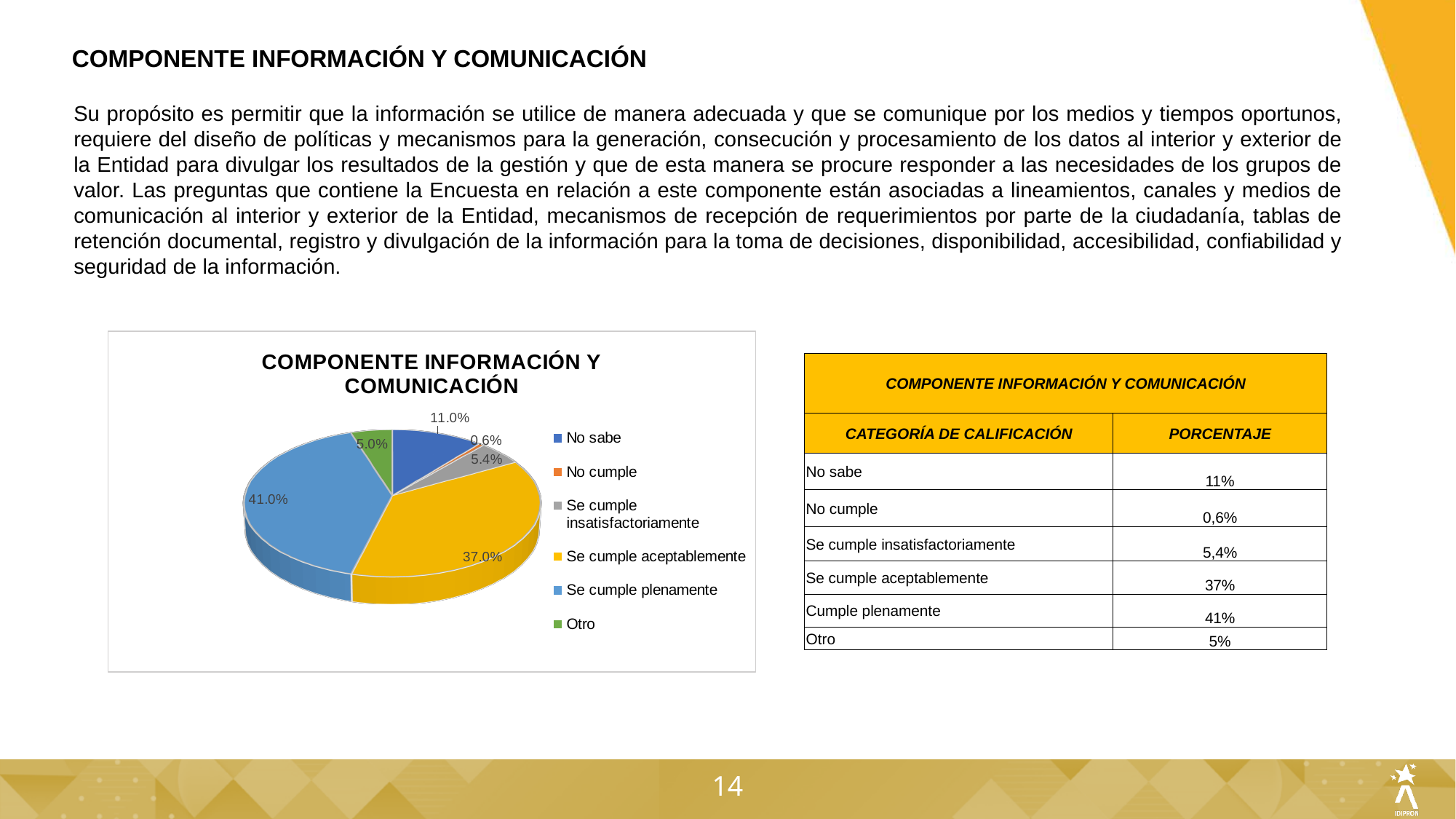
What is the value for "No sabe" in the pie chart? 11.0% What is the value for "No cumple" in the pie chart? 0.6% What is the difference between the values for "Se cumple plenamente" and "Se cumple aceptablemente"? 4.0% What is the value for "Se cumple insatisfactoriamente" in the pie chart? 5.4% How many categories does the pie chart legend list? 6 Which category has the largest slice in the pie chart? Se cumple plenamente Which is larger, the value for "No sabe" or the value for "Se cumple insatisfactoriamente"? No sabe Which category has the smallest slice in the pie chart? No cumple What is the title of the pie chart? COMPONENTE INFORMACIÓN Y COMUNICACIÓN What type of chart is shown on the slide? Pie chart What is the value for "Otro" in the pie chart? 5.0% What is the value for "Se cumple plenamente" in the pie chart? 41.0%